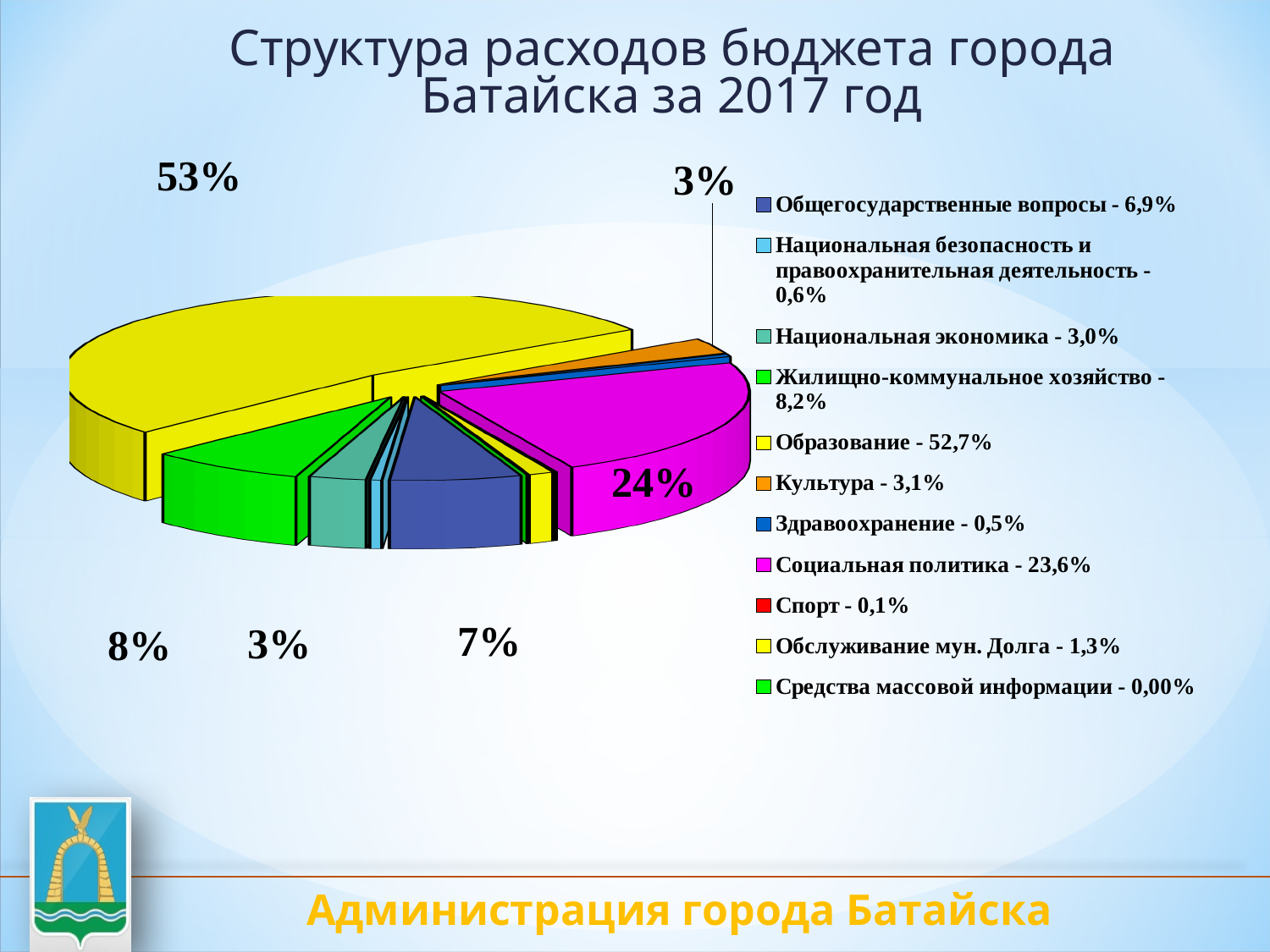
What value is listed for Социальная политика in the legend? 23,6% What value is listed for Культура in the legend? 3,1% How many categories does the legend list? 11 What is the title of the chart on the slide? Структура расходов бюджета города Батайска за 2017 год What share of the budget expenditure does Образование account for according to the legend? 52,7% What is the difference between the shares of Образование and Социальная политика? 29,1% Which is larger: the share for Жилищно-коммунальное хозяйство or for Общегосударственные вопросы? Жилищно-коммунальное хозяйство Which category has the largest share of the budget expenditure? Образование Which category has the smallest share of the budget expenditure? Средства массовой информации What value is listed for Жилищно-коммунальное хозяйство? 8,2% What type of chart is shown on the slide? Pie chart What value is listed for Здравоохранение? 0,5%